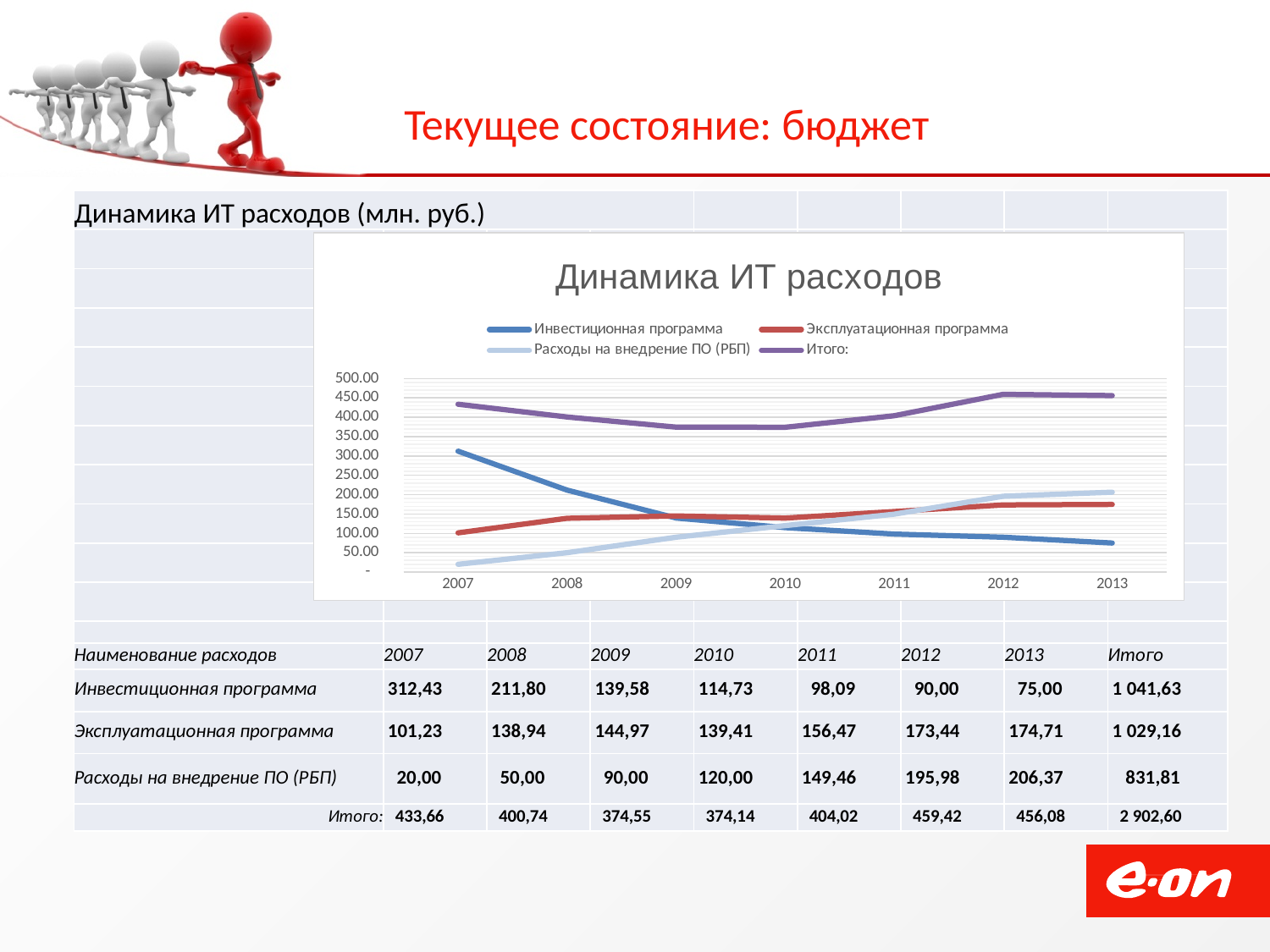
Does the Инвестиционная программа line rise or fall from 2007 to 2013? fall Which is larger in 2013: Эксплуатационная программа or Инвестиционная программа? Эксплуатационная программа In which year is the Итого line at its lowest? 2010 How many series does the chart legend list? 4 How many years are shown on the x axis of the chart? 7 What is the difference between Итого in 2012 and Итого in 2007? 25,76 What kind of chart is shown on the slide? line chart What is the value of Инвестиционная программа in 2007? 312,43 What is the value of Расходы на внедрение ПО (РБП) in 2013? 206,37 In which year is the Инвестиционная программа line at its highest? 2007 Is the value of Итого in 2012 greater or less than 450.00? greater What is the title of the chart? Динамика ИТ расходов